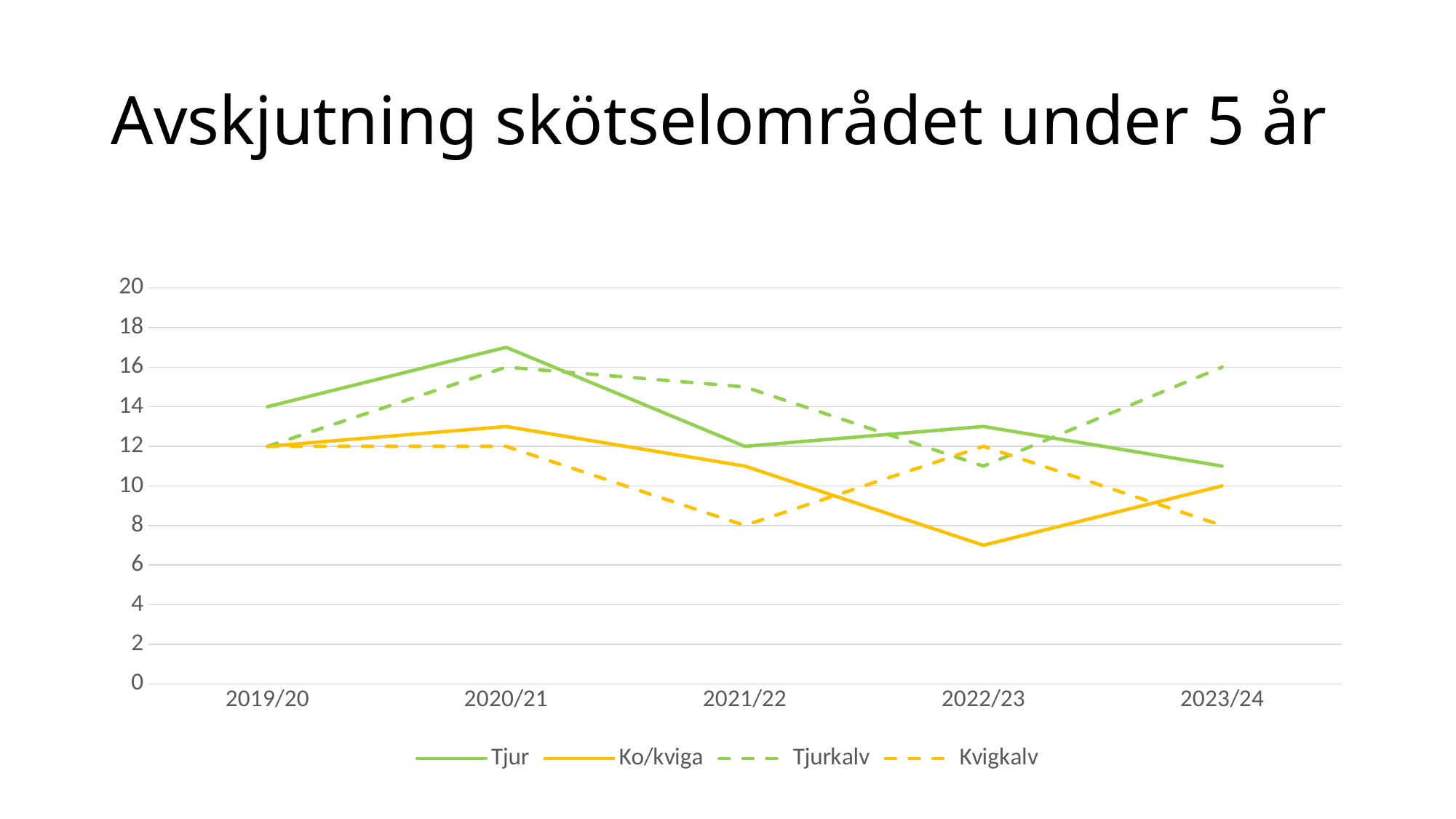
Is the value for Tjur in 2020/21 greater or less than 16? greater What is the value for Tjur in 2019/20? 14 What type of chart is shown on the slide? Line chart What is the title of the chart on the slide? Avskjutning skötselområdet under 5 år In which season is the value for Ko/kviga lowest? 2022/23 Which is larger in 2020/21, Tjur or Ko/kviga? Tjur How many series does the legend list? 4 What is the value for Kvigkalv in 2021/22? 8 What is the value for Tjurkalv in 2023/24? 16 What is the difference between Tjurkalv and Kvigkalv in 2023/24? 8 How many seasons are shown along the x axis? 5 In which season is the value for Tjur highest? 2020/21